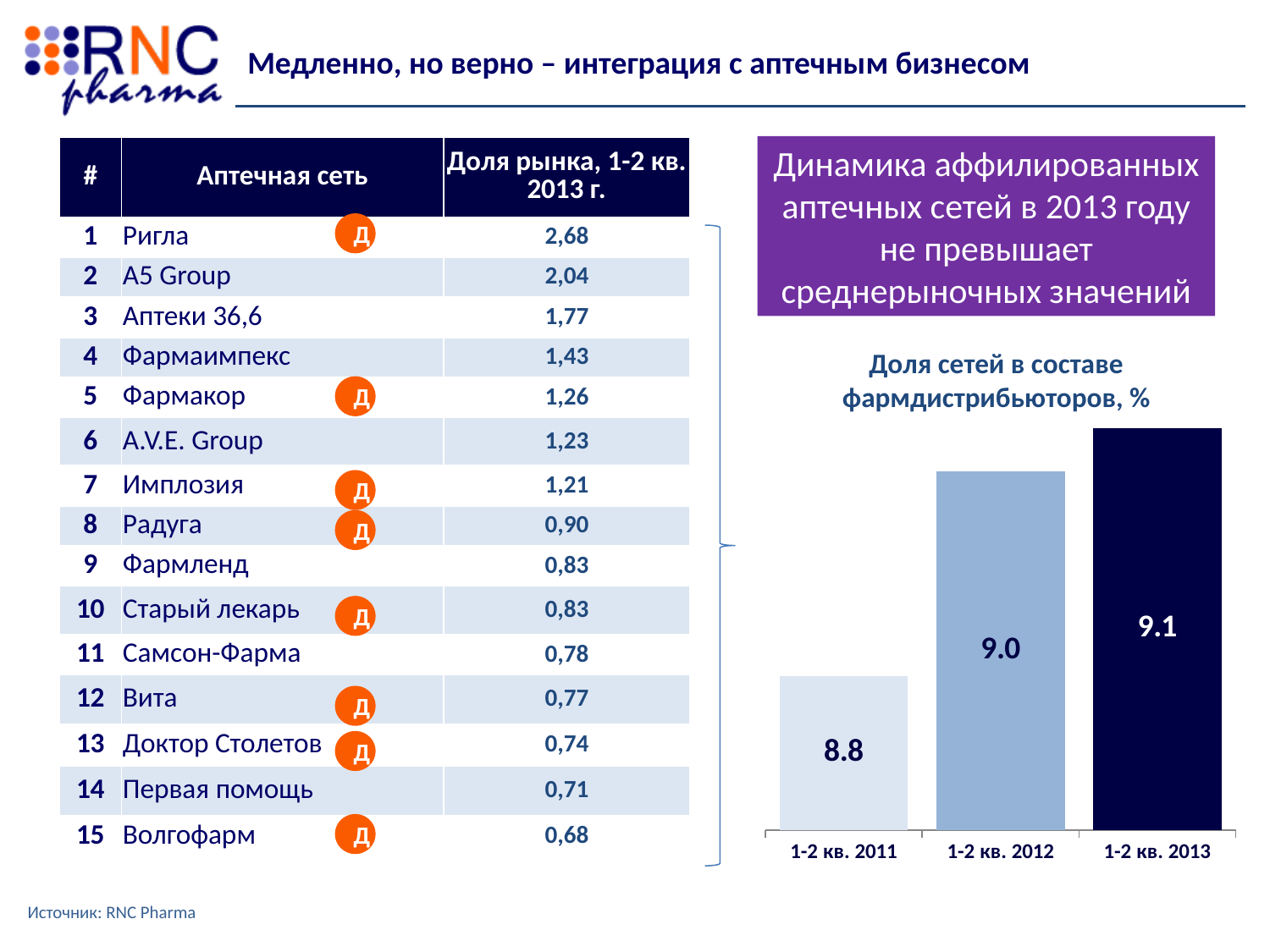
Which period has the lowest value in the chart "Доля сетей в составе фармдистрибьюторов, %"? 1-2 кв. 2011 In the chart "Доля сетей в составе фармдистрибьюторов, %", which is larger: the value for 1-2 кв. 2012 or for 1-2 кв. 2013? 1-2 кв. 2013 How many bars are shown in the chart "Доля сетей в составе фармдистрибьюторов, %"? 3 What is the value for 1-2 кв. 2013 in the chart "Доля сетей в составе фармдистрибьюторов, %"? 9.1 What is the title of the bar chart on the right side of the slide? Доля сетей в составе фармдистрибьюторов, % What is the difference between the values for 1-2 кв. 2013 and 1-2 кв. 2011 in the chart "Доля сетей в составе фармдистрибьюторов, %"? 0.3 What is the value for 1-2 кв. 2011 in the chart "Доля сетей в составе фармдистрибьюторов, %"? 8.8 What is the difference between the values for 1-2 кв. 2012 and 1-2 кв. 2011 in the chart "Доля сетей в составе фармдистрибьюторов, %"? 0.2 What is the value for 1-2 кв. 2012 in the chart "Доля сетей в составе фармдистрибьюторов, %"? 9.0 What type of chart is "Доля сетей в составе фармдистрибьюторов, %"? bar chart Which period has the highest value in the chart "Доля сетей в составе фармдистрибьюторов, %"? 1-2 кв. 2013 Do the values in the chart "Доля сетей в составе фармдистрибьюторов, %" rise or fall from 1-2 кв. 2011 to 1-2 кв. 2013? rise